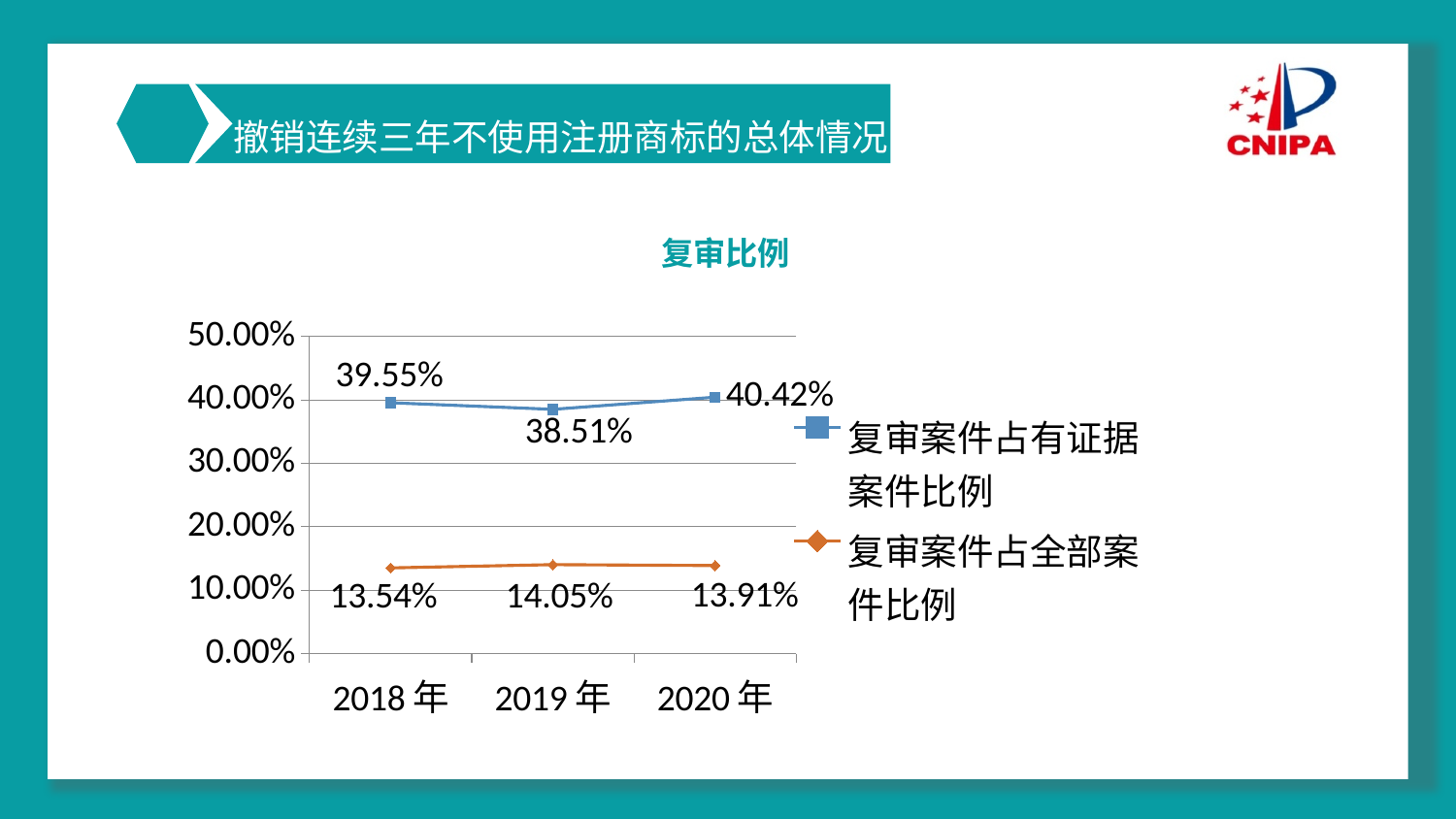
How many series does the legend list? 2 In which year is 复审案件占有证据案件比例 highest? 2020年 Is the value of 复审案件占全部案件比例 in 2019年 greater or less than 20.00%? less What is the value of 复审案件占有证据案件比例 in 2018年? 39.55% What type of chart is shown on the slide? line chart What is the title of the chart? 复审比例 What is the value of 复审案件占全部案件比例 in 2020年? 13.91% What is the difference between 复审案件占有证据案件比例 and 复审案件占全部案件比例 in 2020年? 26.51% What is the value of 复审案件占有证据案件比例 in 2019年? 38.51% Which series has the larger value in 2019年, 复审案件占有证据案件比例 or 复审案件占全部案件比例? 复审案件占有证据案件比例 In which year is 复审案件占全部案件比例 lowest? 2018年 How many years are plotted along the x axis? 3